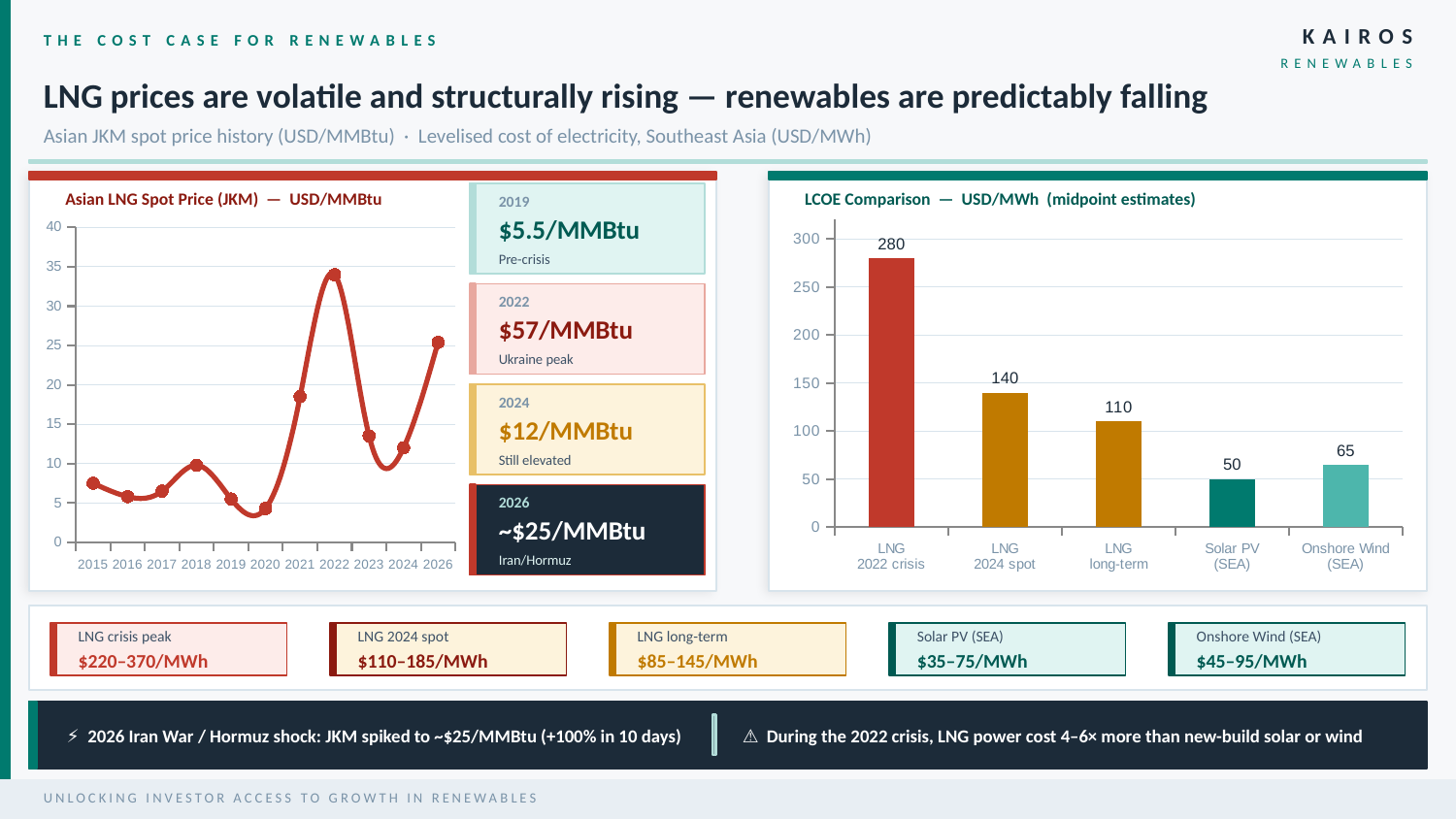
How many data points are plotted in the Asian LNG Spot Price (JKM) chart? 11 In the LCOE Comparison chart, what is the difference between LNG 2024 spot and LNG long-term? 30 In the LCOE Comparison chart, which category has the lowest value? Solar PV (SEA) In the Asian LNG Spot Price (JKM) chart, is the value for 2022 greater or less than 30? greater In the LCOE Comparison chart, what is the value for Solar PV (SEA)? 50 In the LCOE Comparison chart, what is the value for Onshore Wind (SEA)? 65 What kind of chart is the LCOE Comparison chart? Bar chart In the LCOE Comparison chart, which is larger: Onshore Wind (SEA) or Solar PV (SEA)? Onshore Wind (SEA) In the Asian LNG Spot Price (JKM) chart, is the value for 2020 greater or less than 5? less How many categories are shown in the LCOE Comparison chart? 5 In the LCOE Comparison chart, which category has the highest value? LNG 2022 crisis In the LCOE Comparison chart, what is the value for LNG 2022 crisis? 280